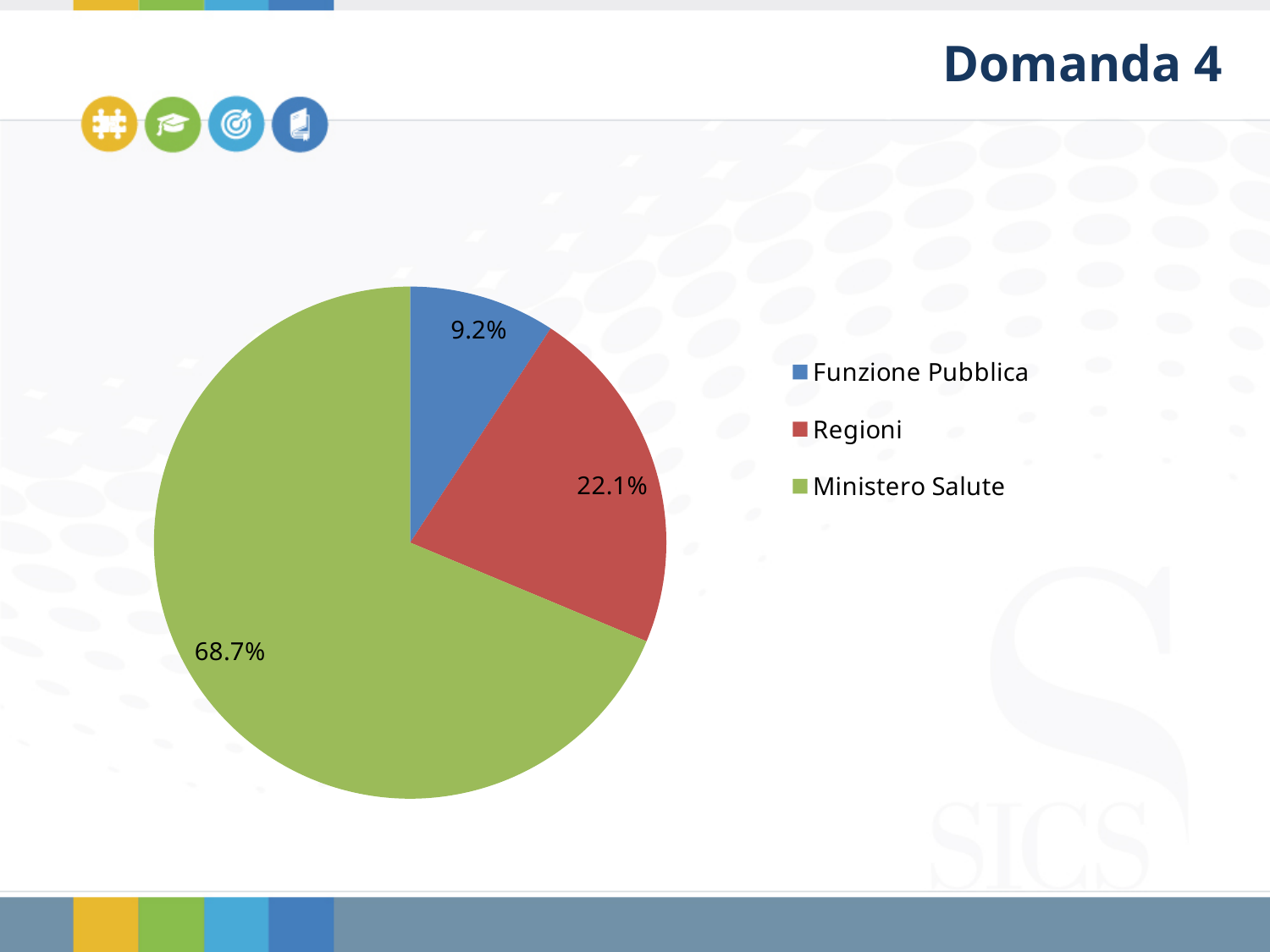
What colour is the slice for Regioni? red What is the title of the slide containing the pie chart? Domanda 4 What share of the pie does Regioni have? 22.1% Which category has the smallest slice of the pie? Funzione Pubblica Which is larger, the slice for Regioni or the slice for Funzione Pubblica? Regioni What share of the pie does Ministero Salute have? 68.7% Which category has the largest slice of the pie? Ministero Salute What kind of chart is shown on the slide? pie chart How many slices does the pie chart have? 3 What is the difference in percentage points between the Regioni slice and the Funzione Pubblica slice? 12.9 What is the difference in percentage points between the Ministero Salute slice and the Regioni slice? 46.6 What share of the pie does Funzione Pubblica have? 9.2%